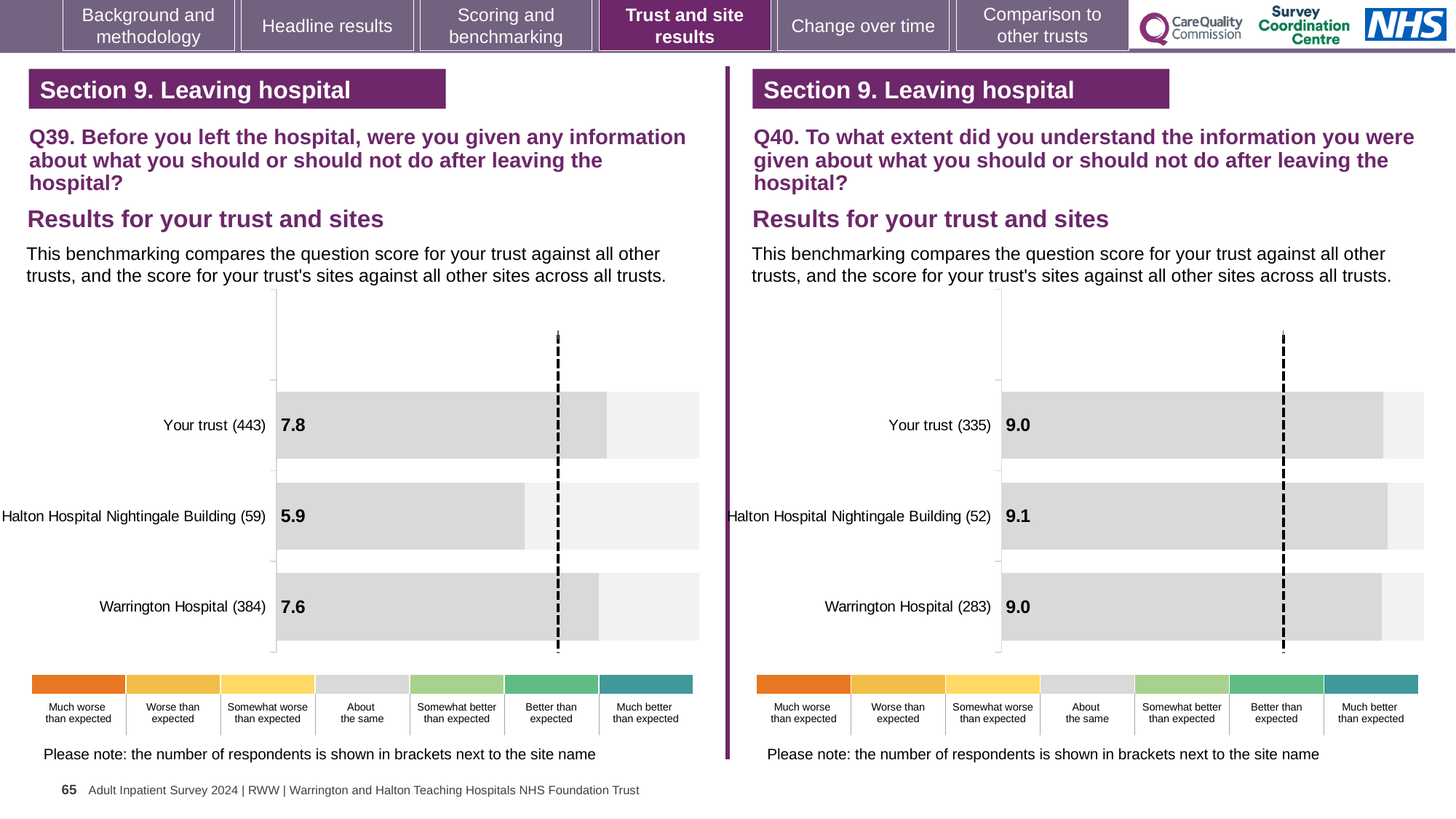
In the Q40 chart on the right, what is the score for Warrington Hospital (283)? 9.0 In the Q40 chart on the right, what is the score for Halton Hospital Nightingale Building (52)? 9.1 In the Q39 chart on the left, what is the score for Halton Hospital Nightingale Building (59)? 5.9 In the Q40 chart on the right, what is the score for Your trust (335)? 9.0 What type of chart is used in the Q39 chart on the left? Bar chart In the Q40 chart on the right, how many bars are plotted? 3 In the Q39 chart on the left, what is the score for Warrington Hospital (384)? 7.6 In the Q39 chart on the left, what is the score for Your trust (443)? 7.8 In the Q40 chart on the right, how many respondents are shown in brackets for Warrington Hospital? 283 In the Q39 chart on the left, what is the difference between the scores for Your trust and Halton Hospital Nightingale Building? 1.9 In the Q39 chart on the left, which has the higher score, Your trust or Warrington Hospital? Your trust In the Q39 chart on the left, which site or trust has the lowest score? Halton Hospital Nightingale Building (59)